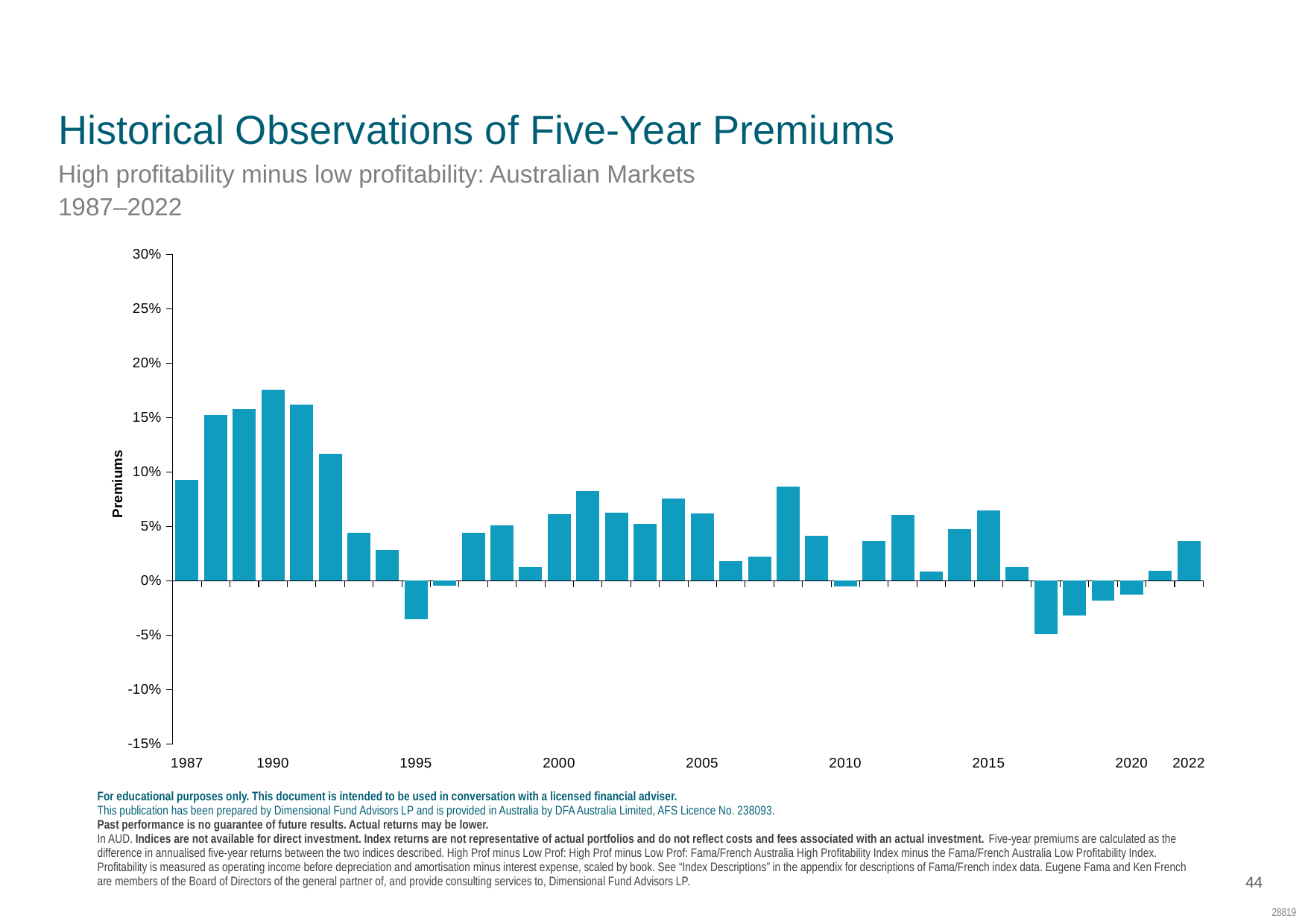
Is the premium for 2000 greater or less than 5%? greater What is the label on the vertical axis of the chart? Premiums Is the premium for 2020 greater or less than 0%? less Is the premium for 1990 greater or less than 15%? greater Which year has the larger premium, 1987 or 2022? 1987 What kind of chart is shown on the slide? Bar chart Do the premiums rise or fall from 1987 to 1990? rise Which year has the larger premium, 1990 or 2000? 1990 Which year has the highest five-year premium in the chart? 1990 Which year has the lowest five-year premium in the chart? 2017